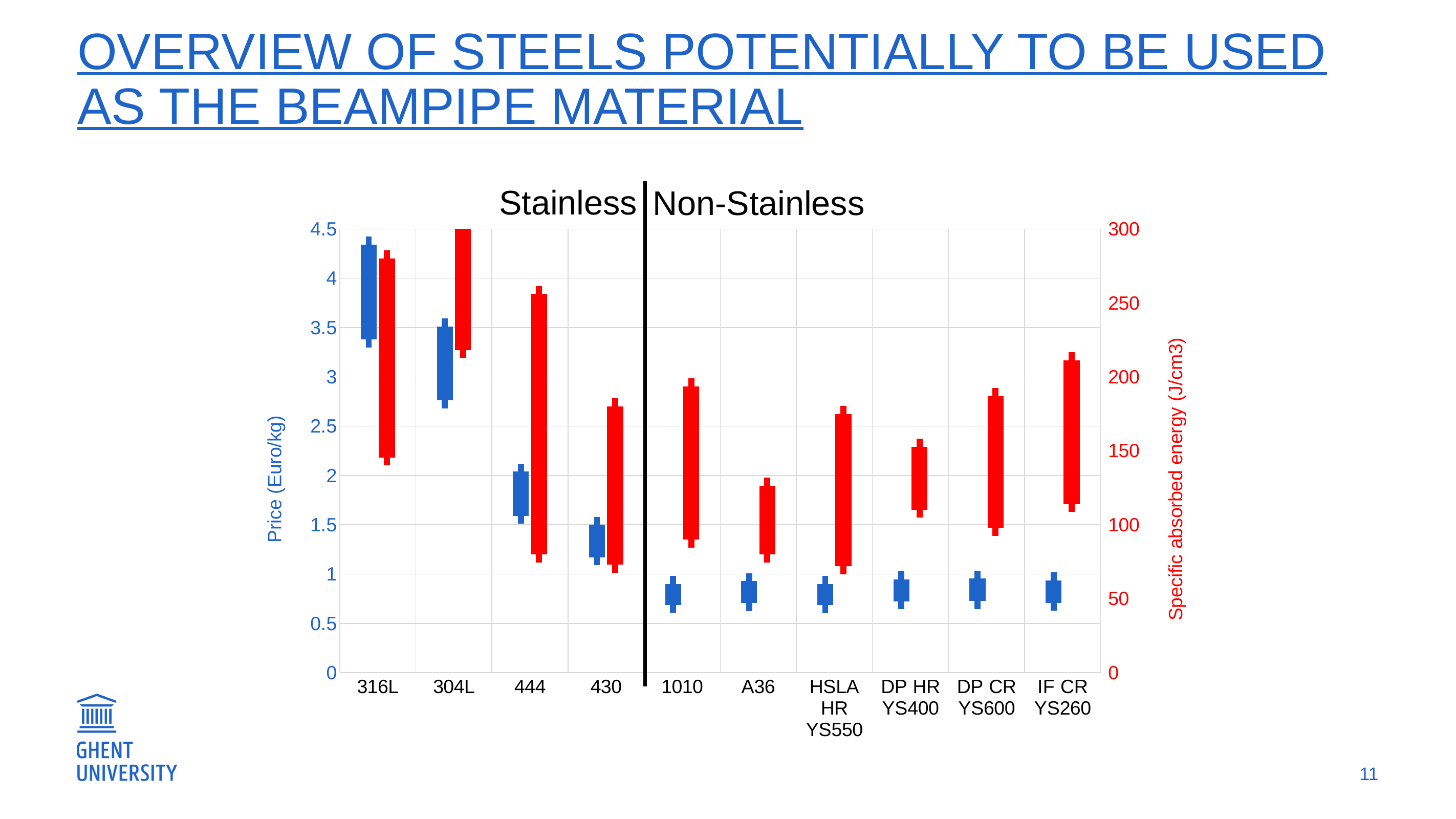
Is the price (Euro/kg) for 316L greater or less than 3? greater What kind of chart is shown on the slide? bar chart What is the label of the right (red) vertical axis of the chart? Specific absorbed energy (J/cm3) How many steel grades are shown on the x axis of the chart? 10 Which steel grade has the highest price (Euro/kg) in the chart? 316L Which steel grade has the highest specific absorbed energy in the chart? 304L How many steel grades are in the Stainless group of the chart? 4 Is the specific absorbed energy for A36 greater or less than 150 J/cm3? less Is the price (Euro/kg) for 1010 greater or less than 1.5? less Which has the higher price (Euro/kg), 316L or 444? 316L What is the label of the left (blue) vertical axis of the chart? Price (Euro/kg)